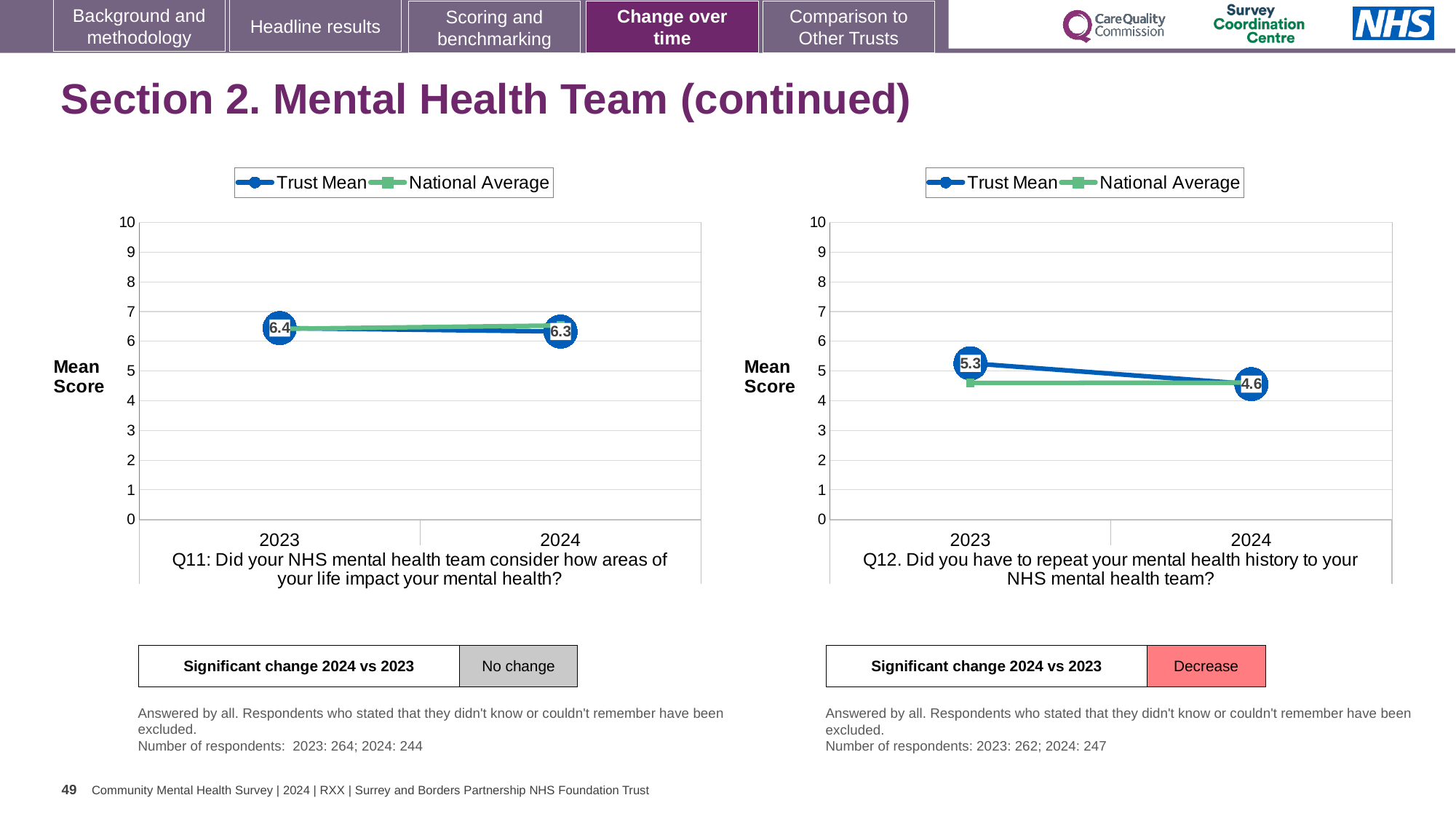
How many years are plotted on the x axis of the Q11 chart? 2 What kind of chart is the Q11 chart? line chart In the Q12 chart, is the National Average for 2023 greater or less than 6? less In the Q11 chart, what is the Trust Mean for 2023? 6.4 How many series does the legend of the Q12 chart list? 2 In the Q11 chart, what is the Trust Mean for 2024? 6.3 In the Q12 chart, does the Trust Mean rise or fall from 2023 to 2024? fall In the Q12 chart, by how much did the Trust Mean fall from 2023 to 2024? 0.7 In the Q12 chart, what is the Trust Mean for 2023? 5.3 In the Q12 chart, what is the Trust Mean for 2024? 4.6 In the Q11 chart, what is the difference between the Trust Mean in 2023 and in 2024? 0.1 What does the 'Significant change 2024 vs 2023' box under the Q12 chart say? Decrease